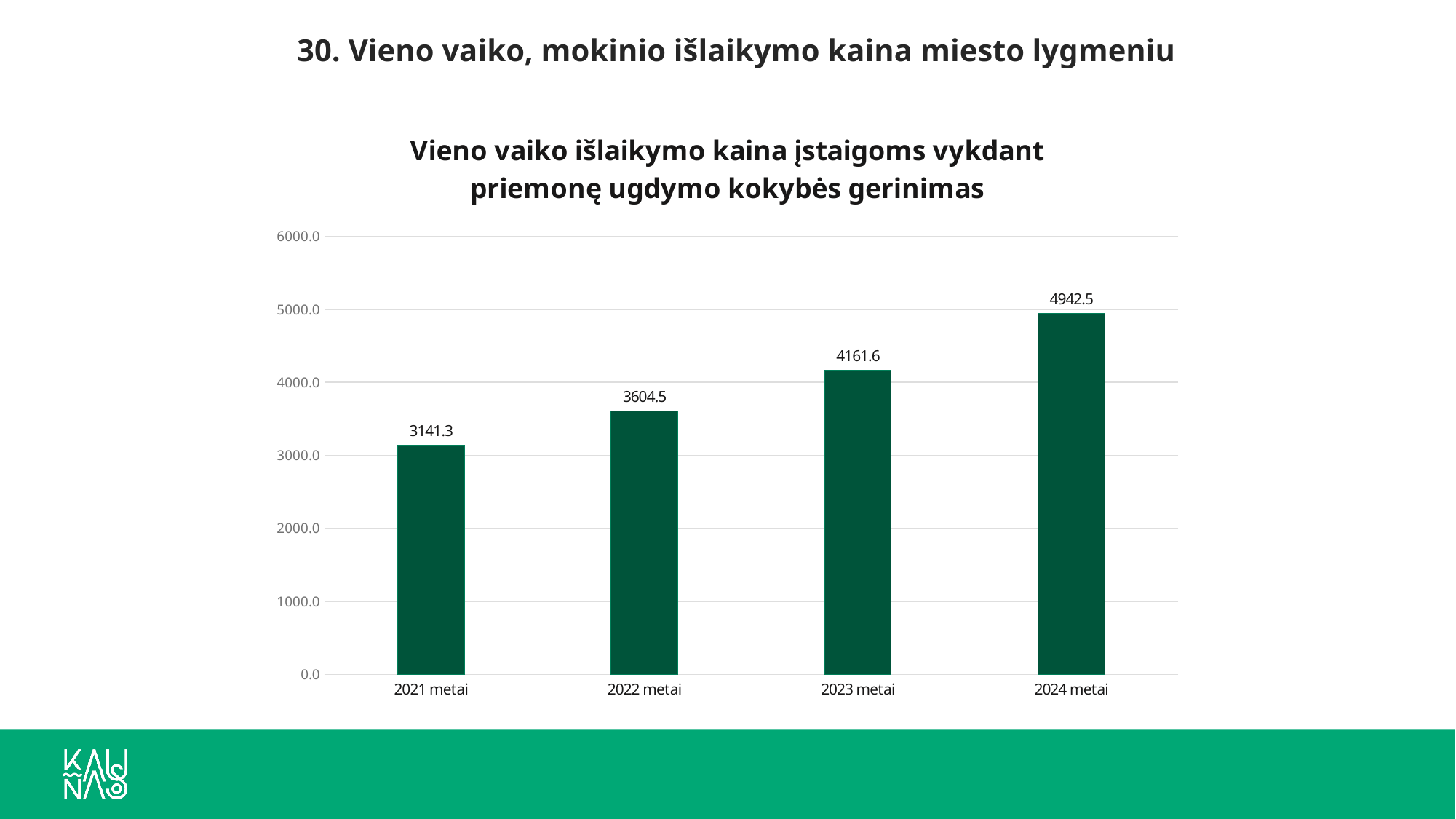
Which year has the highest value? 2024 metai How many years are shown on the x axis? 4 Do the values rise or fall from 2021 metai to 2024 metai? rise Which is larger, the value for 2022 metai or the value for 2023 metai? 2023 metai What is the value for 2021 metai? 3141.3 What kind of chart is shown on the slide? bar chart What is the value for 2024 metai? 4942.5 What is the difference between the values for 2024 metai and 2021 metai? 1801.2 Which year has the lowest value? 2021 metai Is the value for 2022 metai greater or less than 4000.0? less What is the value for 2023 metai? 4161.6 What is the difference between the values for 2022 metai and 2021 metai? 463.2